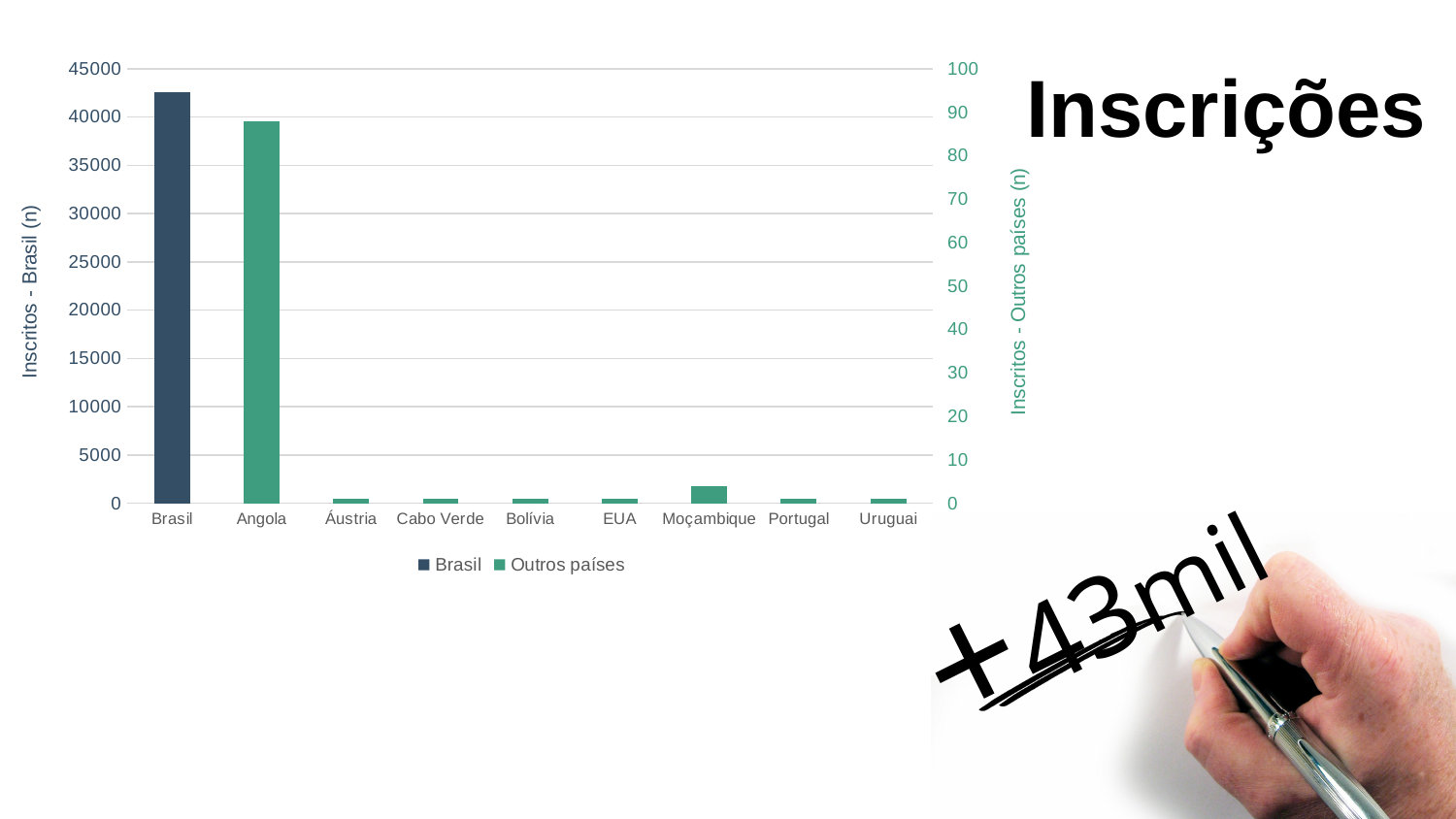
How many countries are shown on the x axis of the chart? 9 What is the title of the left vertical axis of the chart? Inscritos - Brasil (n) How many series does the chart legend list? 2 Is the value for Brasil greater or less than 40000 on the left axis? greater Among the countries in the Outros países series, which has the highest bar? Angola Is the value for Angola greater or less than 80 on the right axis? greater Which has the taller bar, Angola or Moçambique? Angola Is the value for Moçambique greater or less than 10 on the right axis? less What are the two series named in the chart legend? Brasil and Outros países What kind of chart is shown on the slide? bar chart Which has the taller bar, Moçambique or Portugal? Moçambique